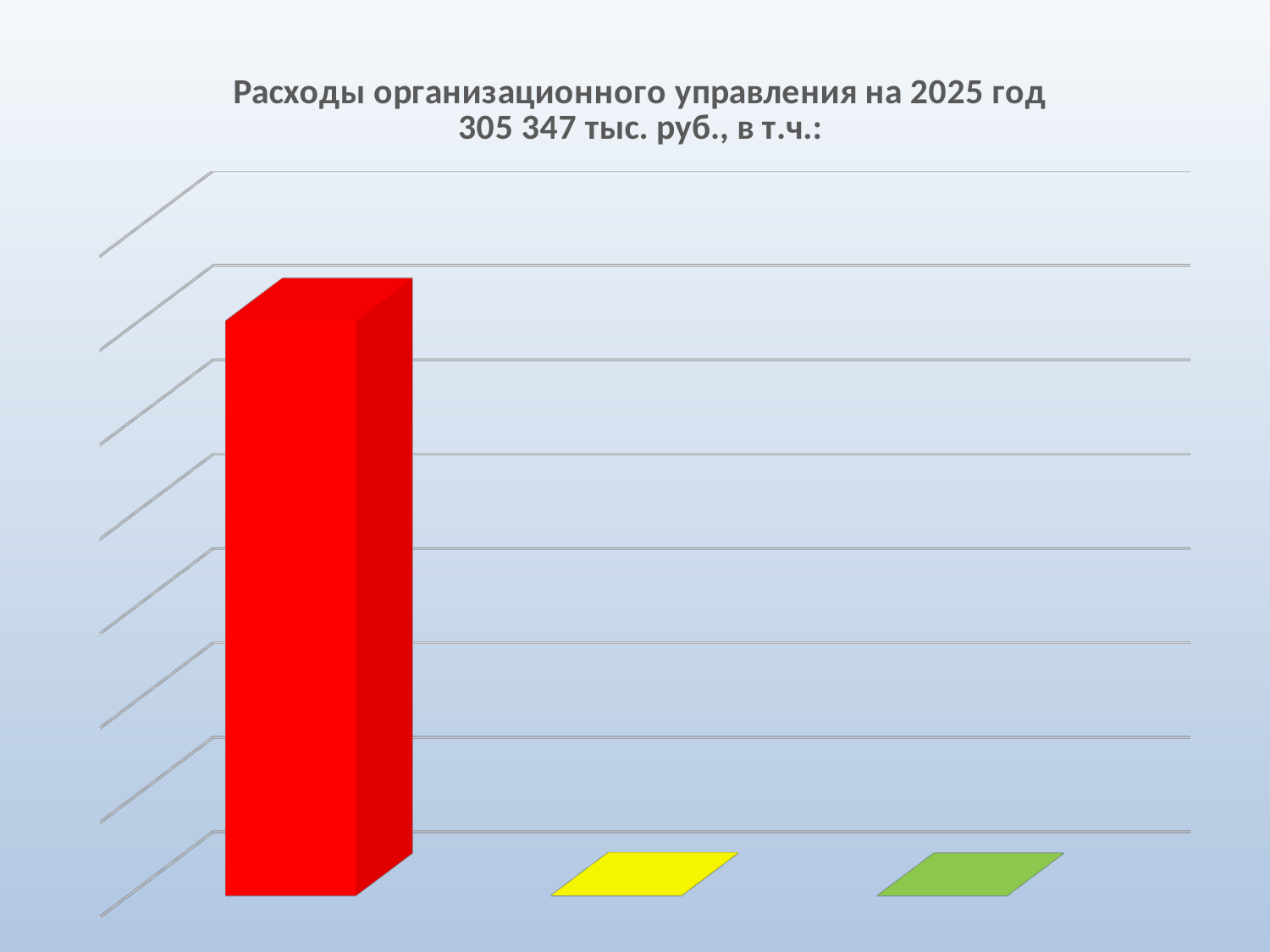
What total amount is stated in the chart title? 305 347 тыс. руб. How many bars are plotted in the chart? 3 Is the green bar taller or shorter than the red bar? shorter Is the red bar taller or shorter than the yellow bar? taller What kind of chart is shown on the slide? bar chart Which bar is the tallest in the chart? the red bar (leftmost) What is the title of the chart? Расходы организационного управления на 2025 год 305 347 тыс. руб., в т.ч.: